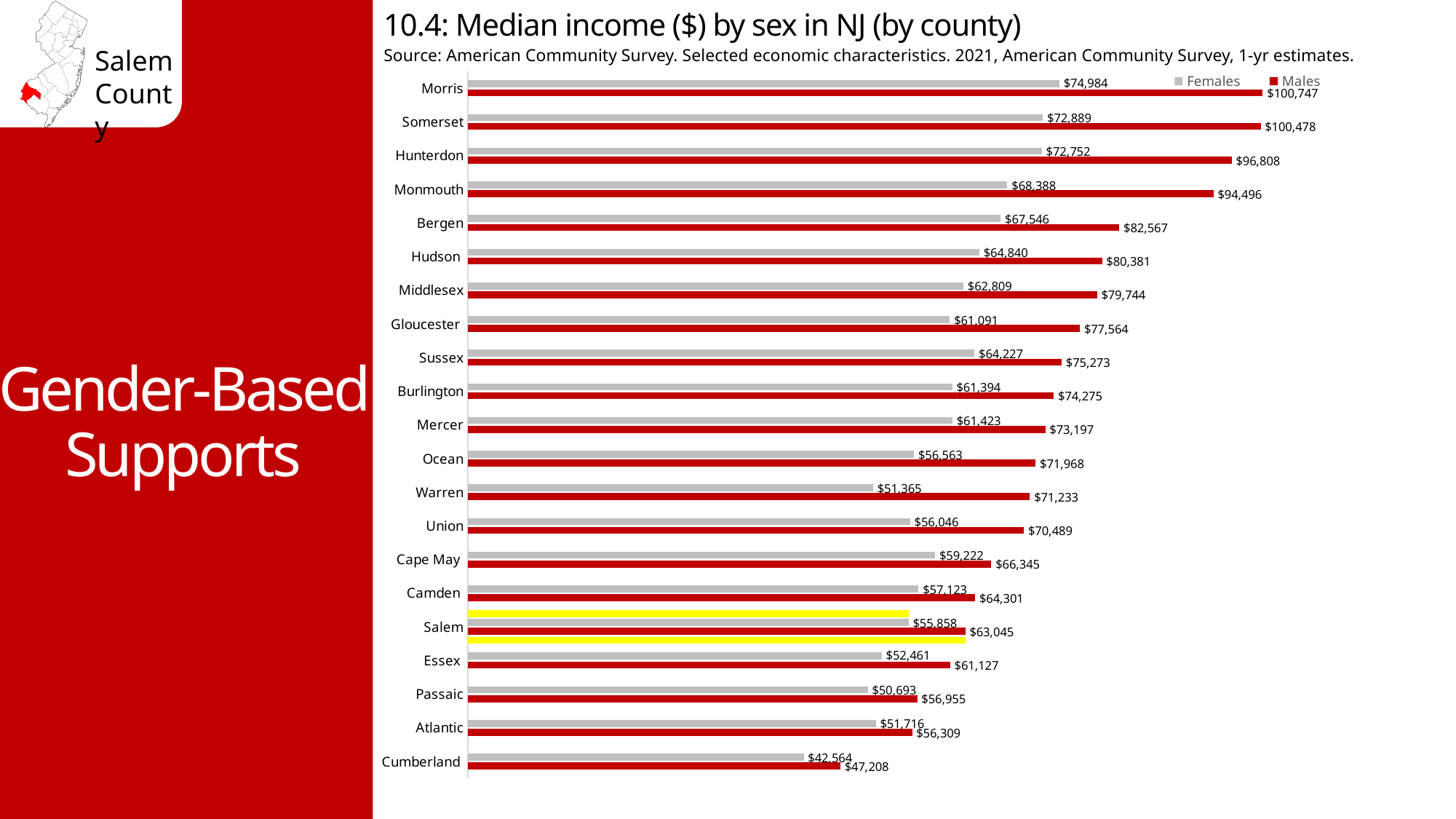
What is the difference between male and female median income in Salem County? $7,187 Which county has the highest median income for females? Morris What is the median income for females in Warren County? $51,365 What is the difference between male and female median income in Morris County? $25,763 What is the median income for males in Salem County? $63,045 What type of chart is shown on the slide? Bar chart Which county has the lowest median income for females? Cumberland Which is larger: the female median income in Sussex County or in Gloucester County? Sussex How many counties are shown in the chart? 21 What is the median income for males in Hunterdon County? $96,808 What is the median income for females in Salem County? $55,858 How many series does the legend list? 2